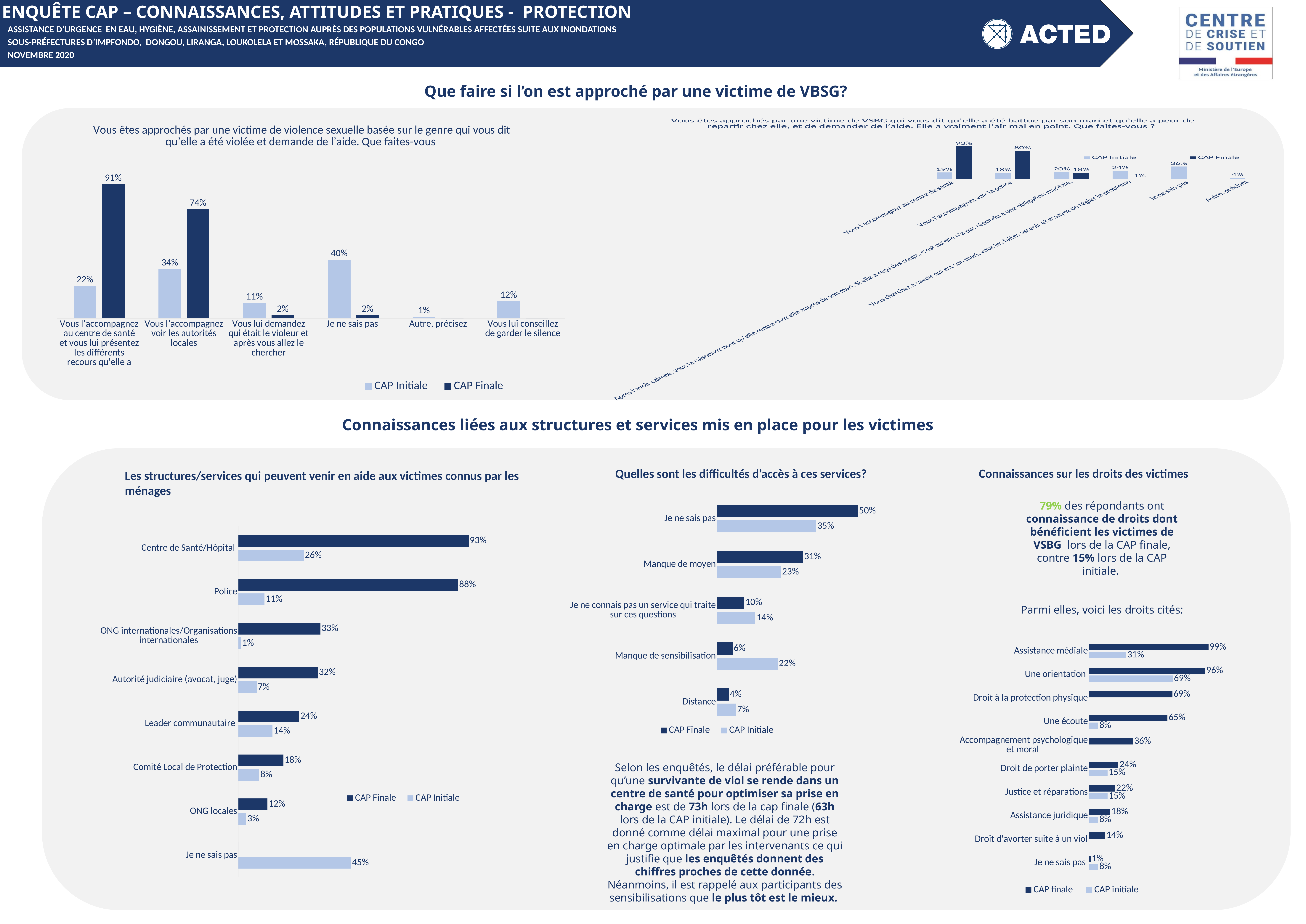
In the chart 'Les structures/services qui peuvent venir en aide aux victimes connus par les ménages', what is the CAP Initiale value for 'Je ne sais pas'? 45% In the chart 'Parmi elles, voici les droits cités', which right has the highest CAP finale value? Assistance médiale In the chart 'Parmi elles, voici les droits cités', how many categories are listed on the axis? 10 What type of chart is 'Quelles sont les difficultés d'accès à ces services?'? Bar chart In the top-left chart about a victim of sexual violence who was raped, which is larger for 'Je ne sais pas': CAP Initiale or CAP Finale? CAP Initiale In the chart 'Les structures/services qui peuvent venir en aide aux victimes connus par les ménages', what is the CAP Finale value for Police? 88% In the chart 'Quelles sont les difficultés d'accès à ces services?', what is the difference between the CAP Finale and CAP Initiale values for 'Manque de sensibilisation'? 16% In the top-left chart about a victim of sexual violence who was raped, what is the difference between the CAP Finale and CAP Initiale values for accompanying the victim to the health centre? 69% In the chart 'Quelles sont les difficultés d'accès à ces services?', which category has the highest CAP Finale value? Je ne sais pas In the chart 'Parmi elles, voici les droits cités', what is the CAP finale value for 'Une écoute'? 65% In the chart 'Quelles sont les difficultés d'accès à ces services?', which category has the lowest CAP Finale value? Distance In the top-left chart about a victim of sexual violence who was raped, what is the CAP Finale value for 'Vous l'accompagnez voir les autorités locales'? 74%